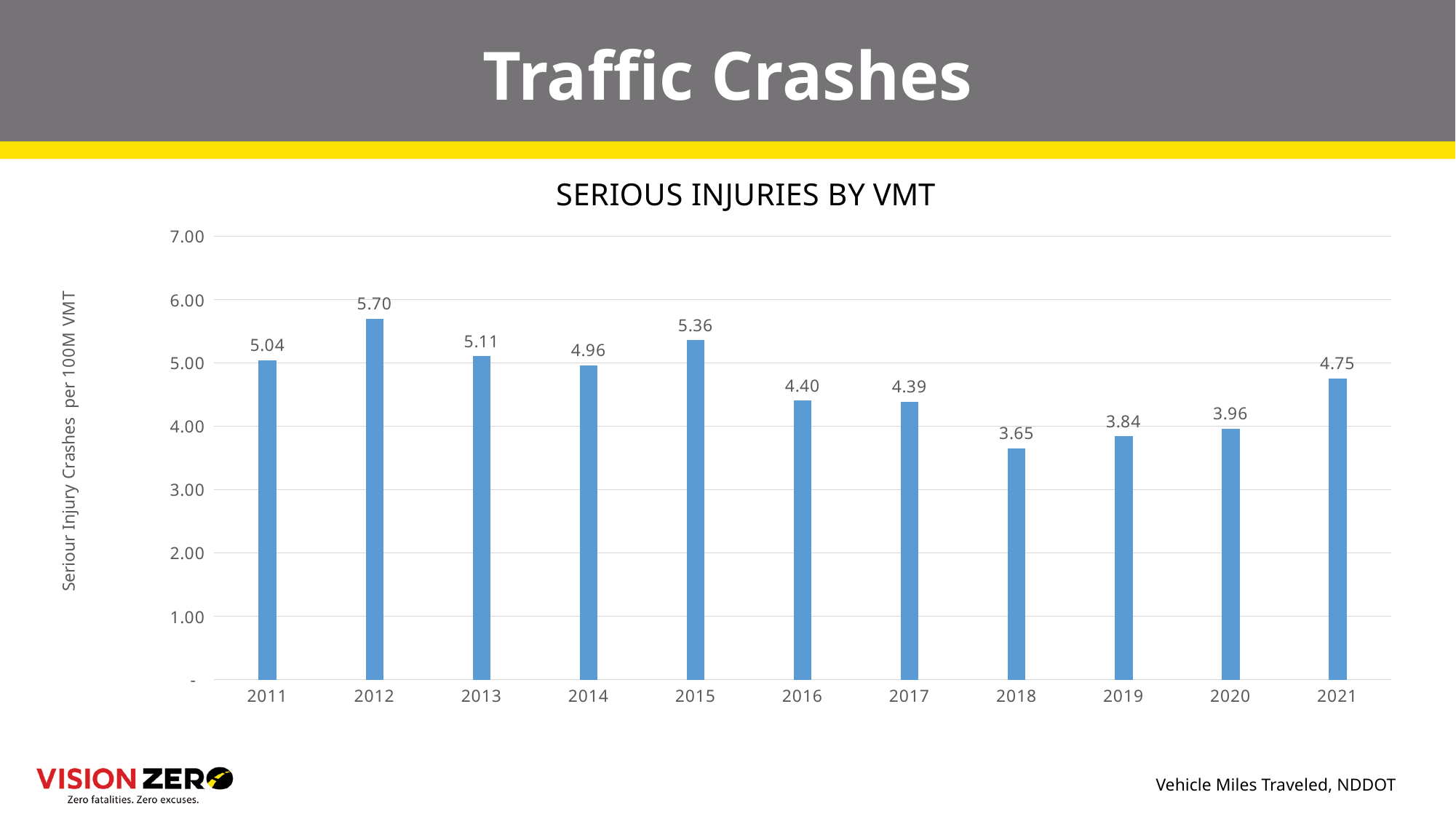
What is the difference between the values for 2012 and 2018? 2.05 What is the value for 2021? 4.75 What kind of chart is this? bar chart Do the values generally rise or fall from 2012 to 2018? fall Which year has the lowest value? 2018 Which year has the highest value? 2012 Which is larger, the value for 2015 or the value for 2016? 2015 How many years are shown on the x axis? 11 What is the value for 2018? 3.65 What is the value for 2012? 5.70 Is the value for 2019 greater or less than 4.00? less What is the title of the chart? SERIOUS INJURIES BY VMT